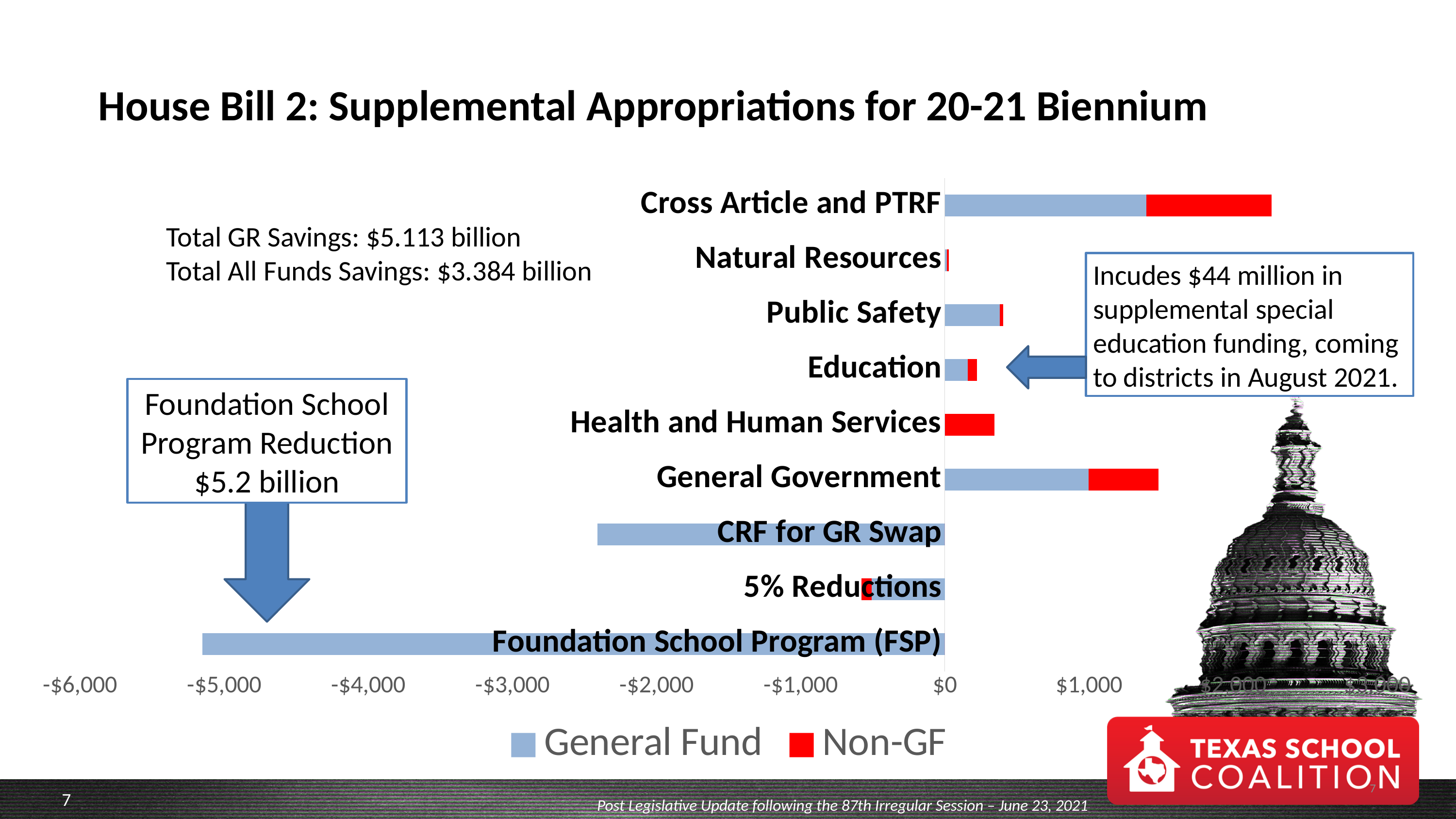
Is the value for CRF for GR Swap greater or less than -$2,000? less Which has a larger total value, Health and Human Services or Education? Health and Human Services Which has a larger total value, Cross Article and PTRF or General Government? Cross Article and PTRF Is the General Fund value for Foundation School Program (FSP) greater or less than -$4,000? less Which category has the highest total value on the chart? Cross Article and PTRF According to the callout on the slide, what is the Foundation School Program reduction? $5.2 billion Which category has the lowest (most negative) value on the chart? Foundation School Program (FSP) How many series does the chart's legend list? 2 Is the total value for General Government greater or less than $1,000? greater What are the two series named in the chart's legend? General Fund and Non-GF What kind of chart is shown on the slide? bar chart How many categories are plotted on the chart? 9